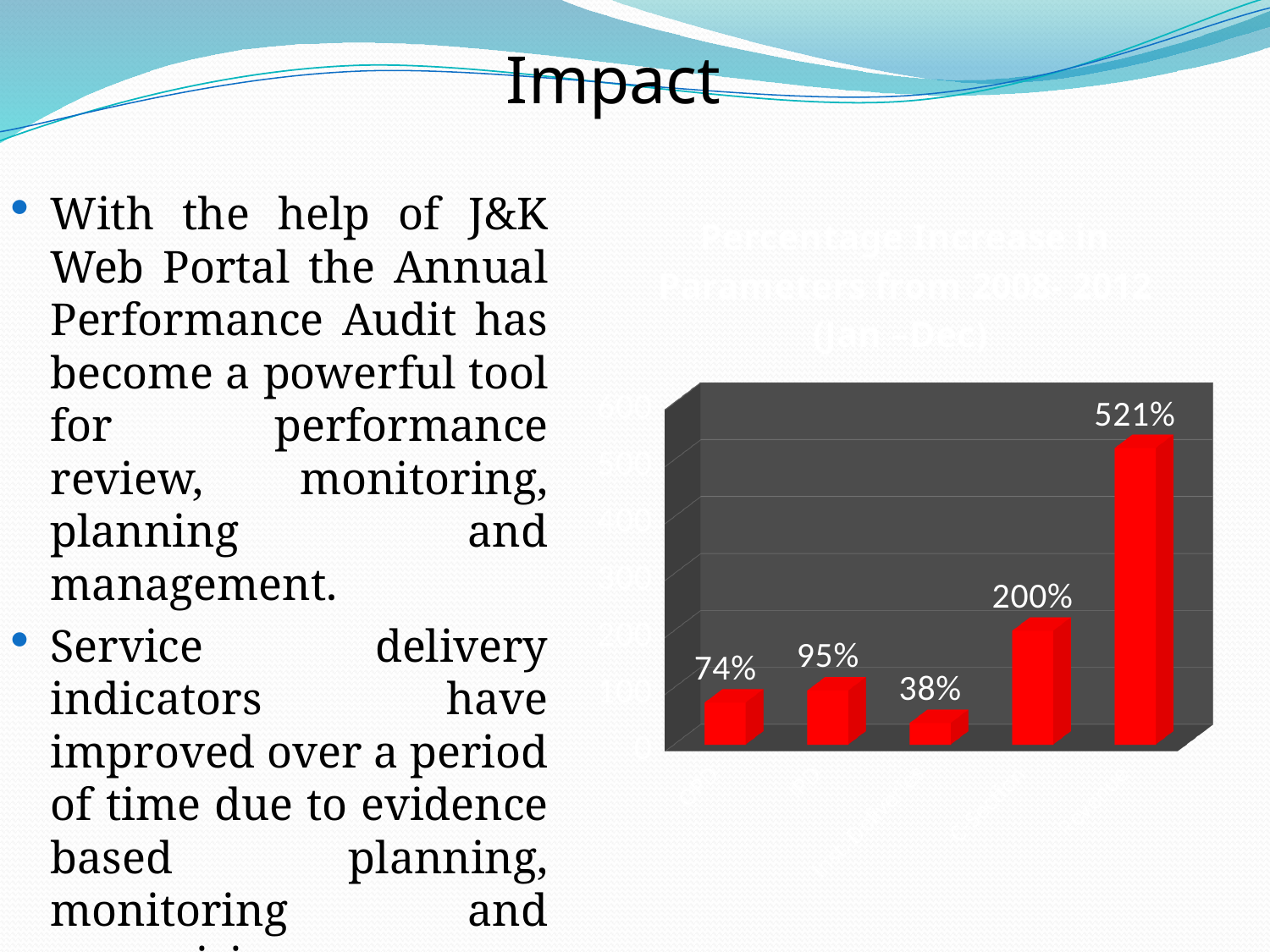
What is the value of the first (leftmost) bar in the chart? 74% What is the lowest value shown in the chart? 38% What is the highest value shown in the chart? 521% Which is larger, the value of the first bar or the value of the third bar? the first bar (74%) Is the value of the rightmost bar greater or less than 500? greater What colour are the bars in the chart? red What is the value of the second bar from the left in the chart? 95% What is the value of the fourth bar from the left in the chart? 200% What kind of chart is shown on the slide? bar chart What is the difference between the second bar (95%) and the first bar (74%)? 21% How many bars are plotted in the chart? 5 What is the difference between the rightmost bar (521%) and the fourth bar (200%)? 321%